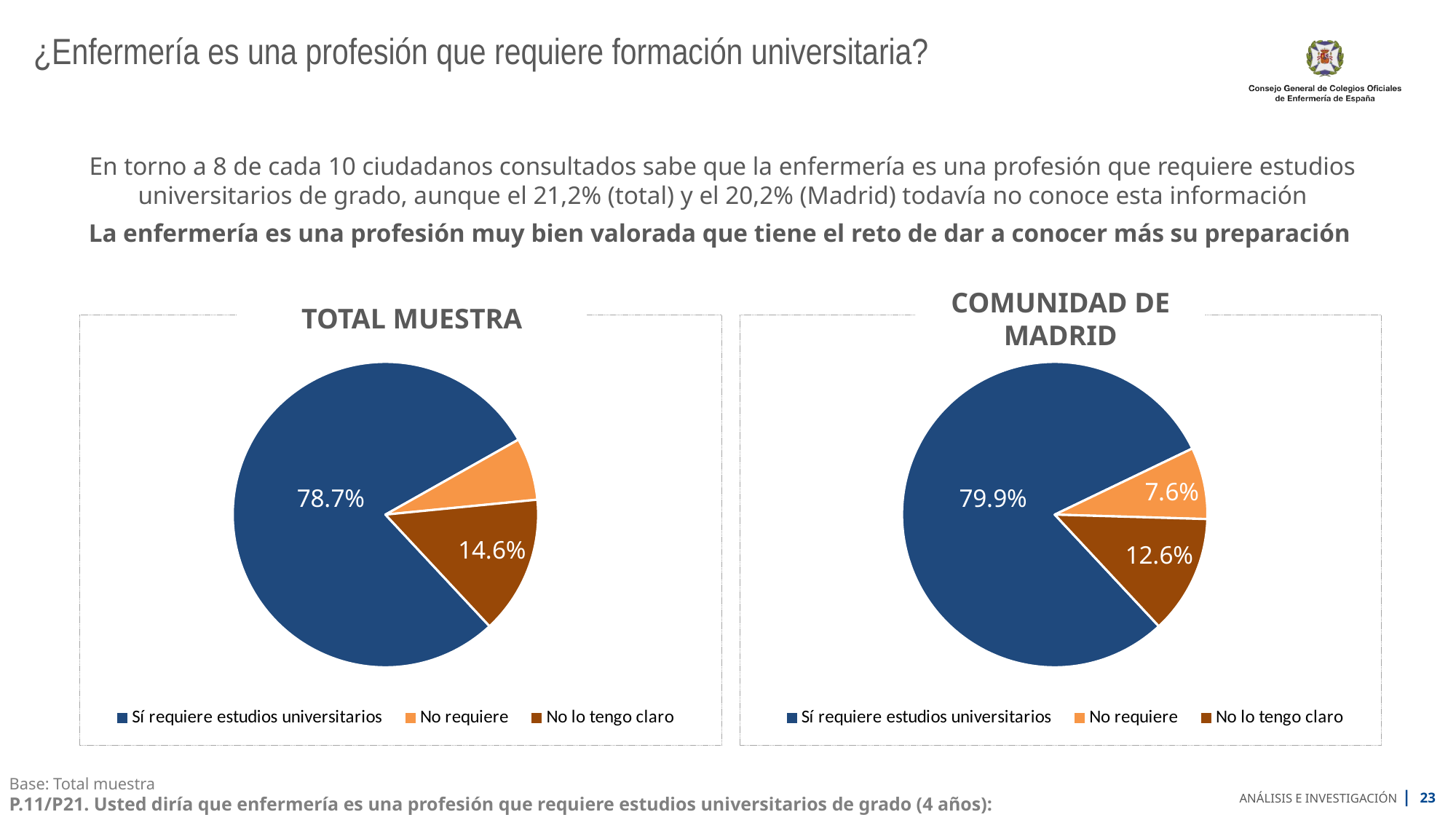
In the COMUNIDAD DE MADRID chart, which category has the smallest slice? No requiere In the TOTAL MUESTRA chart, which category has the largest slice? Sí requiere estudios universitarios In the TOTAL MUESTRA chart, what percentage corresponds to 'Sí requiere estudios universitarios'? 78.7% In the COMUNIDAD DE MADRID chart, what percentage corresponds to 'No lo tengo claro'? 12.6% In the COMUNIDAD DE MADRID chart, what percentage corresponds to 'No requiere'? 7.6% In the COMUNIDAD DE MADRID chart, what is the difference between 'No lo tengo claro' and 'No requiere'? 5.0% How many categories does the legend of the TOTAL MUESTRA chart list? 3 What type of chart is used for COMUNIDAD DE MADRID? Pie chart In the TOTAL MUESTRA chart, what colour is the 'No requiere' slice? Light orange Which chart shows a larger share for 'Sí requiere estudios universitarios', TOTAL MUESTRA or COMUNIDAD DE MADRID? COMUNIDAD DE MADRID In the COMUNIDAD DE MADRID chart, what percentage corresponds to 'Sí requiere estudios universitarios'? 79.9% In the TOTAL MUESTRA chart, what percentage corresponds to 'No lo tengo claro'? 14.6%